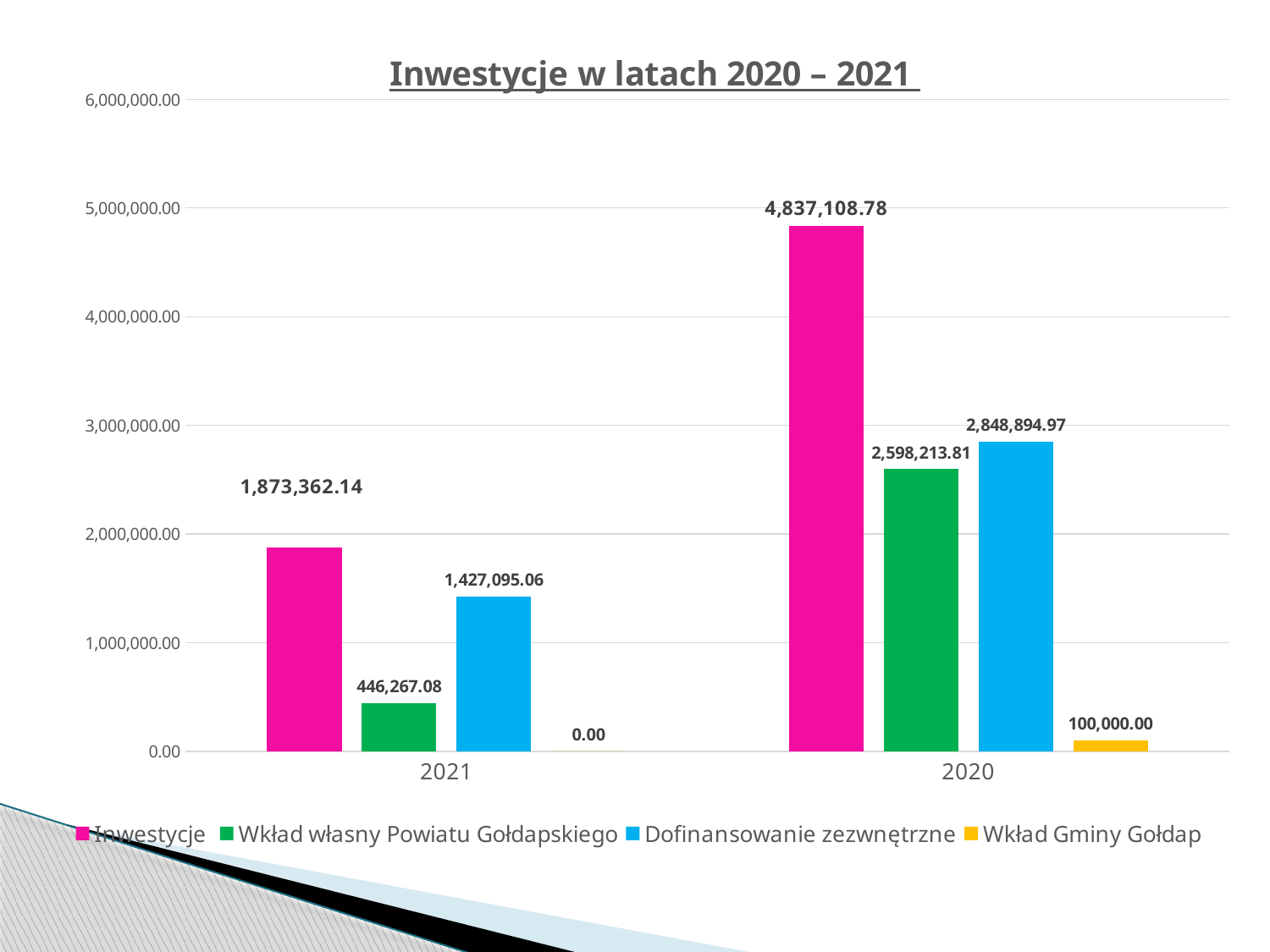
Which series has the lowest value in 2020? Wkład Gminy Gołdap Which year has the higher value for Inwestycje? 2020 How many series does the legend list? 4 What is the value of Wkład własny Powiatu Gołdapskiego for 2021? 446,267.08 How many year categories are shown on the x axis? 2 What is the value of Wkład Gminy Gołdap for 2021? 0.00 What is the title of the chart? Inwestycje w latach 2020 – 2021 What type of chart is shown on the slide? Bar chart What is the difference between the Inwestycje values for 2020 and 2021? 2,963,746.64 What is the value of Dofinansowanie zezwnętrzne for 2020? 2,848,894.97 What is the difference between Dofinansowanie zezwnętrzne and Wkład własny Powiatu Gołdapskiego in 2020? 250,681.16 What is the value of Inwestycje for 2020? 4,837,108.78